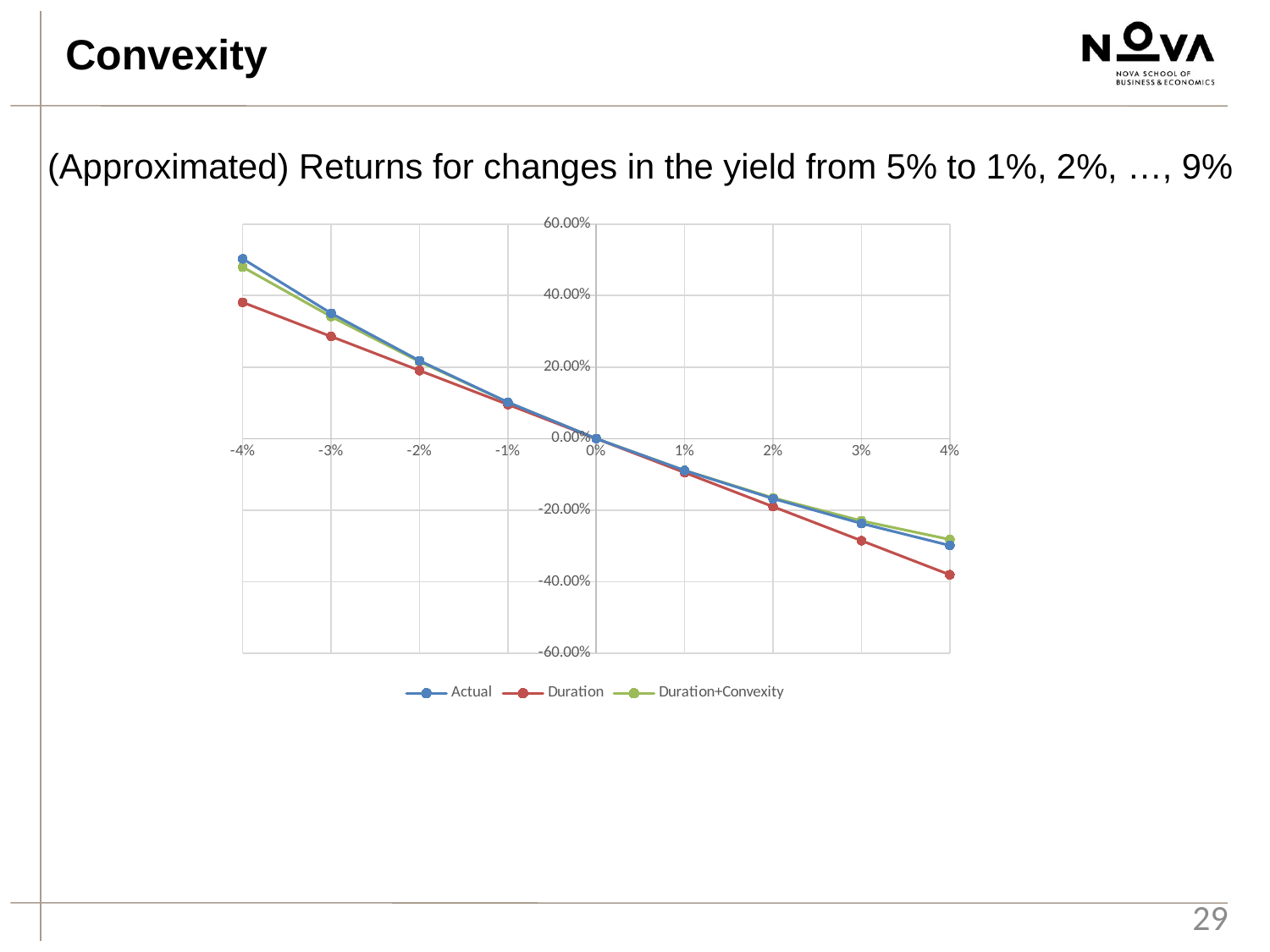
At -4%, which series has the larger value, Actual or Duration? Actual Is the value of the Duration series at 3% greater or less than -20.00%? less Is the value of the Duration series at 4% greater or less than -20.00%? less Is the value of the Actual series at -4% greater or less than 40.00%? greater How many series does the legend list? 3 How many data points does each series have along the x axis? 9 Do the values of the Actual series rise or fall as the yield change moves from -4% to 4%? fall At 4%, which series has the larger value, Duration or Duration+Convexity? Duration+Convexity What colour is the line for the Duration series? red What kind of chart is shown on the slide? line chart Which series has the lowest value at 4%? Duration